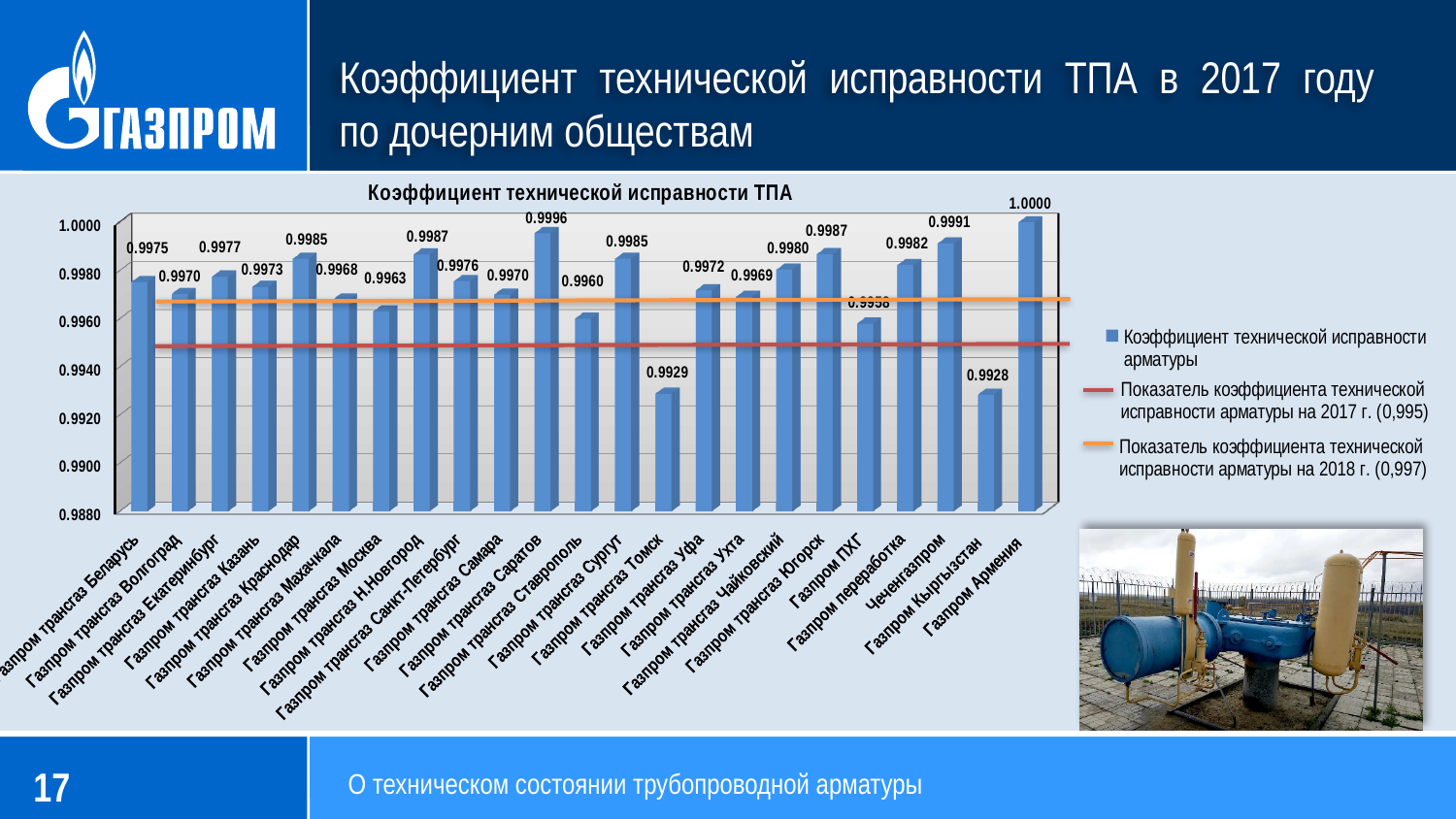
Is the value for Газпром трансгаз Томск greater or less than 0.9940? less According to the legend, what is the target coefficient value for 2018? 0,997 What kind of chart is shown? bar chart What is the value for Чеченгазпром? 0.9991 What is the difference between the values for Газпром Армения and Газпром Кыргызстан? 0.0072 What is the value for Газпром трансгаз Саратов? 0.9996 How many entries does the legend list? 3 Which is larger, the value for Газпром трансгаз Краснодар or Газпром трансгаз Москва? Газпром трансгаз Краснодар Which subsidiary has the highest coefficient? Газпром Армения What is the value for Газпром трансгаз Томск? 0.9929 How many subsidiaries are shown on the x axis? 23 What is the difference between the values for Газпром трансгаз Саратов and Газпром трансгаз Ставрополь? 0.0036